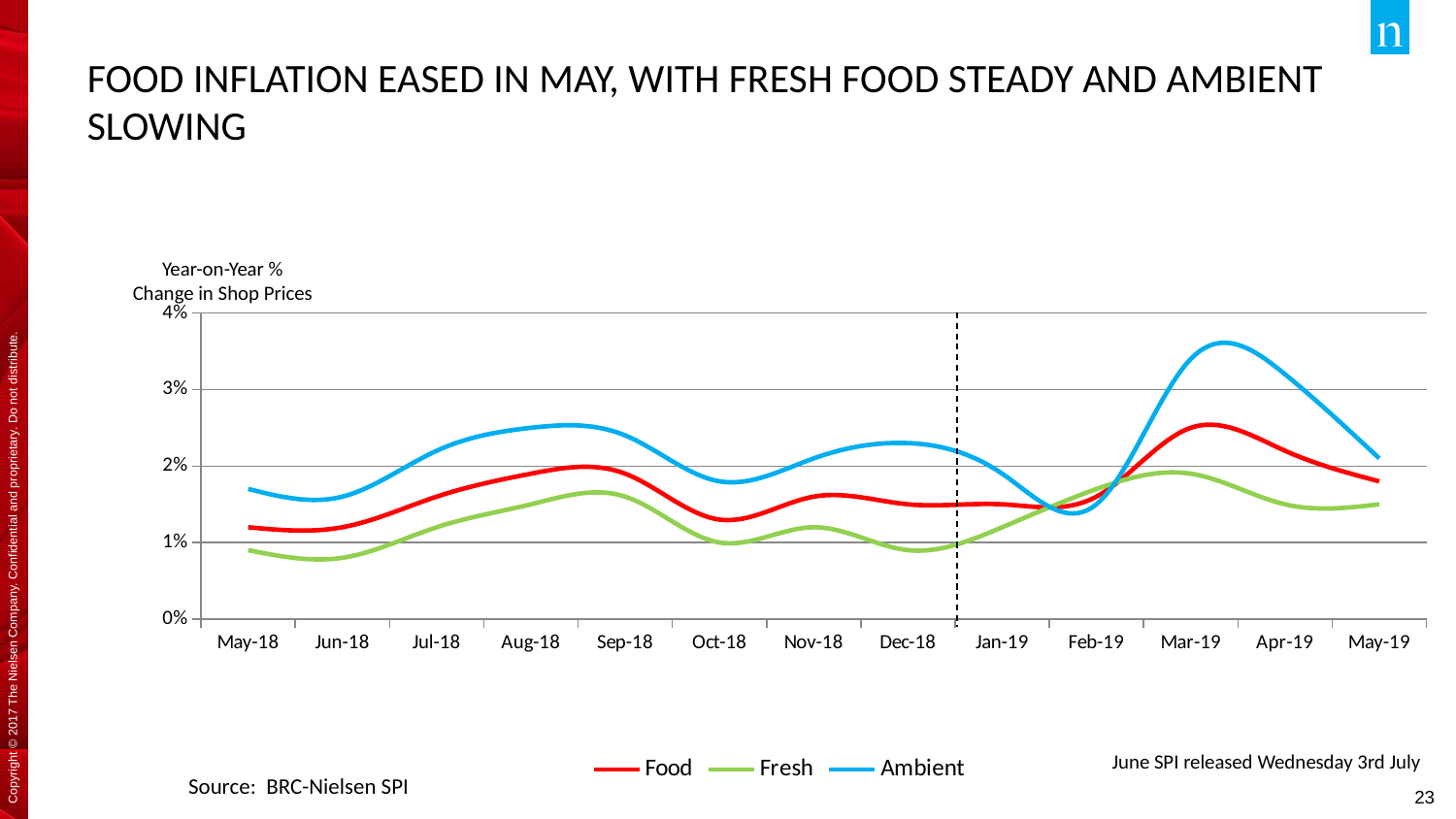
Which series has the lowest value in May-18? Fresh In which month does the Ambient line reach its highest value? Mar-19 Does the Ambient line rise or fall from Mar-19 to May-19? fall How many months are shown along the x axis? 13 Is the value for Fresh in Jun-18 greater or less than 1%? less Is the value for Food in May-19 greater or less than 2%? less In Aug-18, which is larger, the Ambient value or the Fresh value? Ambient How many series does the legend list? 3 What kind of chart is shown on the slide? line chart Is the value for Ambient in Mar-19 greater or less than 3%? greater What colour is the Fresh line in the legend? green